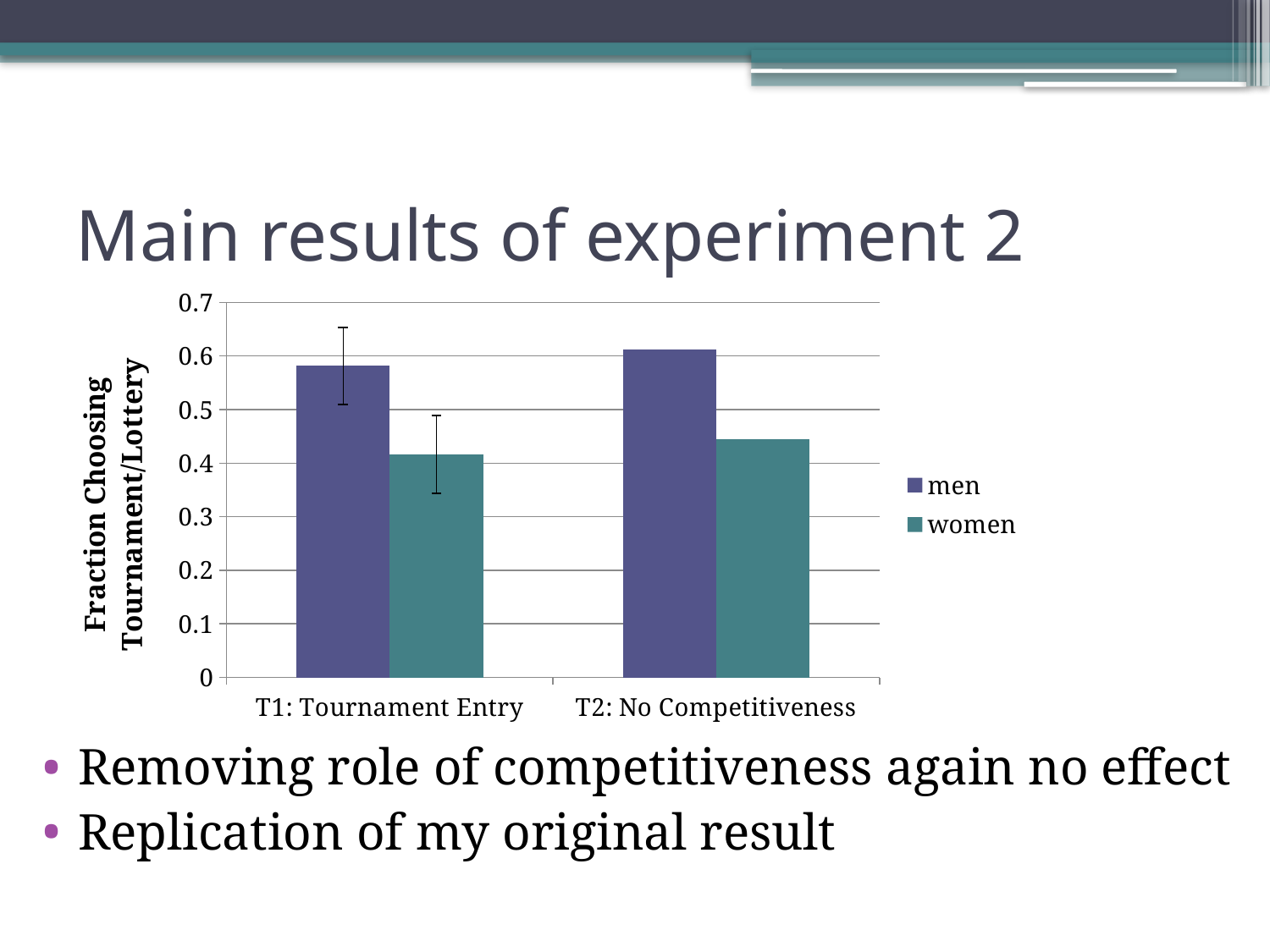
What is the title of the y axis? Fraction Choosing Tournament/Lottery Which bar is the lowest in the chart? women in T1: Tournament Entry Is the value for men in T1: Tournament Entry greater or less than 0.5? greater Is the value for women in T2: No Competitiveness greater or less than 0.4? greater Is the value for women in T1: Tournament Entry greater or less than 0.5? less How many series does the legend list? 2 How many treatment categories are shown on the x axis? 2 In T1: Tournament Entry, which series has the larger value, men or women? men What kind of chart is shown on the slide? bar chart Which bar is the highest in the chart? men in T2: No Competitiveness For men, which treatment has the larger value, T1: Tournament Entry or T2: No Competitiveness? T2: No Competitiveness